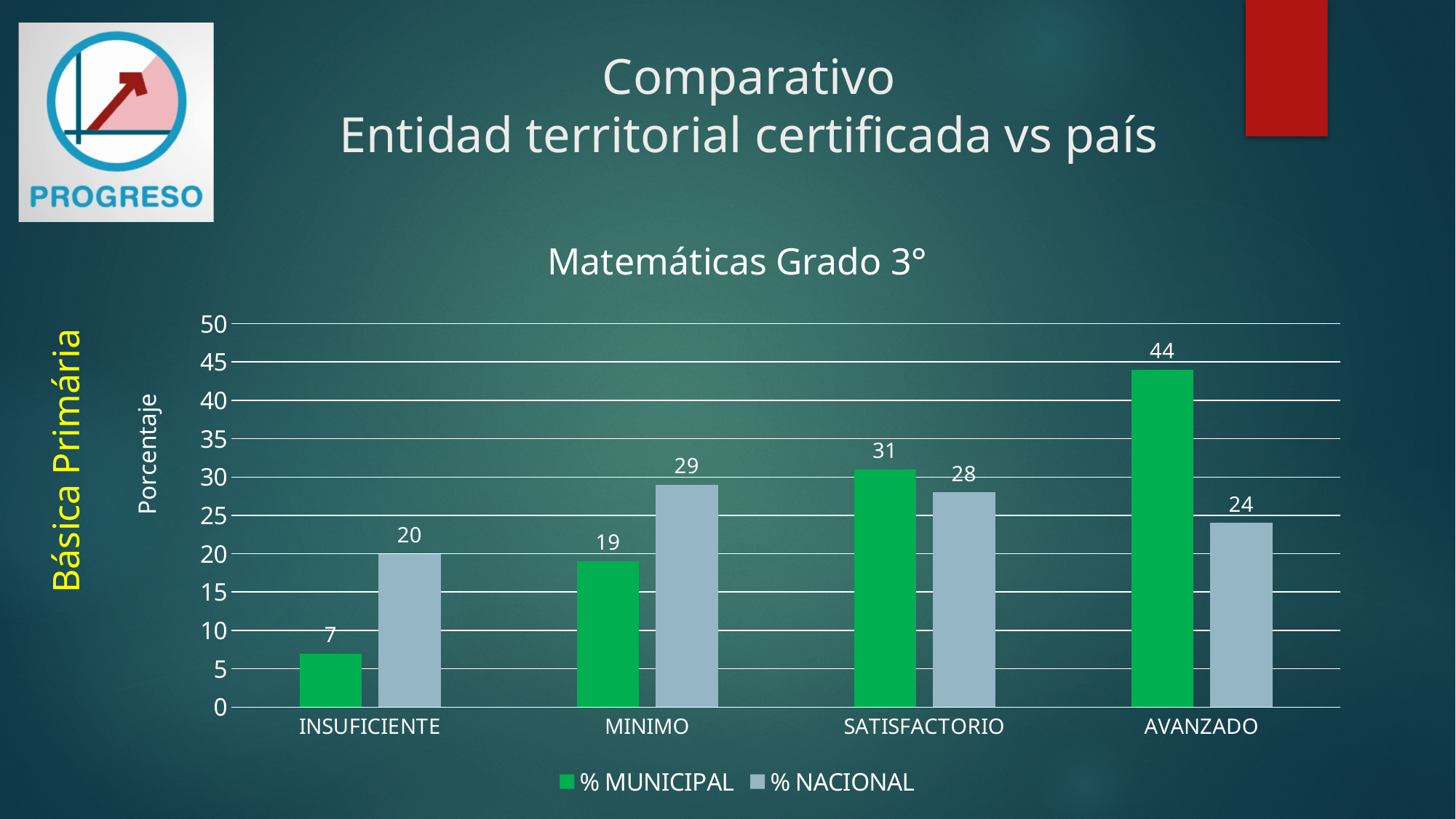
What is the % MUNICIPAL value for AVANZADO? 44 What kind of chart is shown on the slide? Bar chart Which category has the highest % MUNICIPAL value? AVANZADO Which category has the highest % NACIONAL value? MINIMO How many categories are shown on the x axis? 4 What is the % NACIONAL value for SATISFACTORIO? 28 Which is larger for MINIMO: % MUNICIPAL or % NACIONAL? % NACIONAL What is the % NACIONAL value for INSUFICIENTE? 20 What is the % MUNICIPAL value for MINIMO? 19 Which category has the lowest % MUNICIPAL value? INSUFICIENTE How many series does the legend list? 2 What is the difference between the % MUNICIPAL and % NACIONAL values for AVANZADO? 20